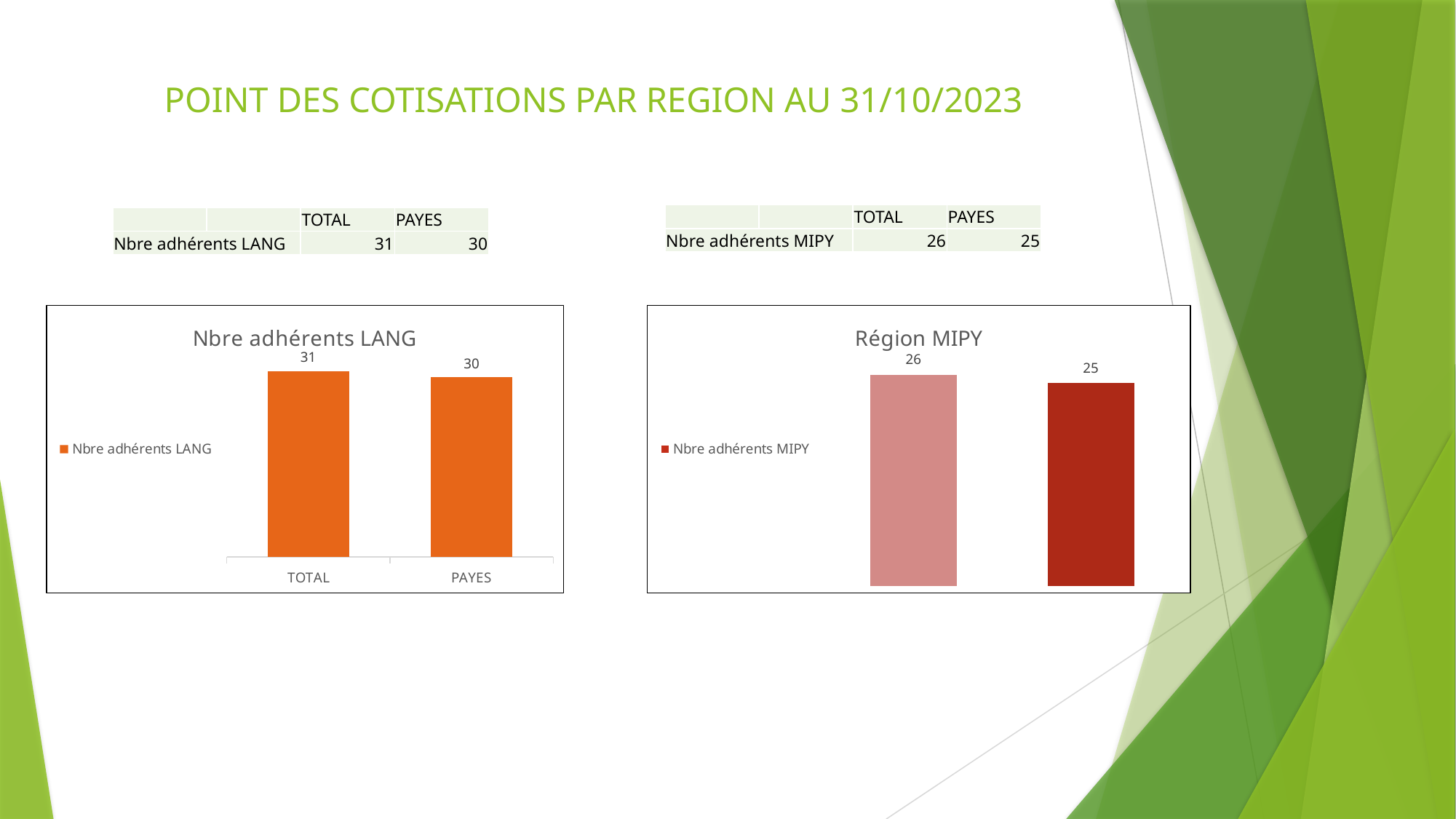
In the 'Région MIPY' chart, which category has the lowest value? PAYES In the 'Région MIPY' chart, what is the value for PAYES? 25 In the 'Nbre adhérents LANG' chart, what is the value for TOTAL? 31 In the 'Nbre adhérents LANG' chart, which category has the higher value, TOTAL or PAYES? TOTAL In the 'Région MIPY' chart, what is the value for TOTAL? 26 In the 'Région MIPY' chart, what is the difference between TOTAL and PAYES? 1 How many categories are shown in the 'Nbre adhérents LANG' chart? 2 How many series does the legend of the 'Région MIPY' chart list? 1 What kind of chart is the 'Région MIPY' chart? Bar chart In the 'Nbre adhérents LANG' chart, what is the value for PAYES? 30 What is the legend entry in the 'Nbre adhérents LANG' chart? Nbre adhérents LANG In the 'Nbre adhérents LANG' chart, what is the difference between TOTAL and PAYES? 1